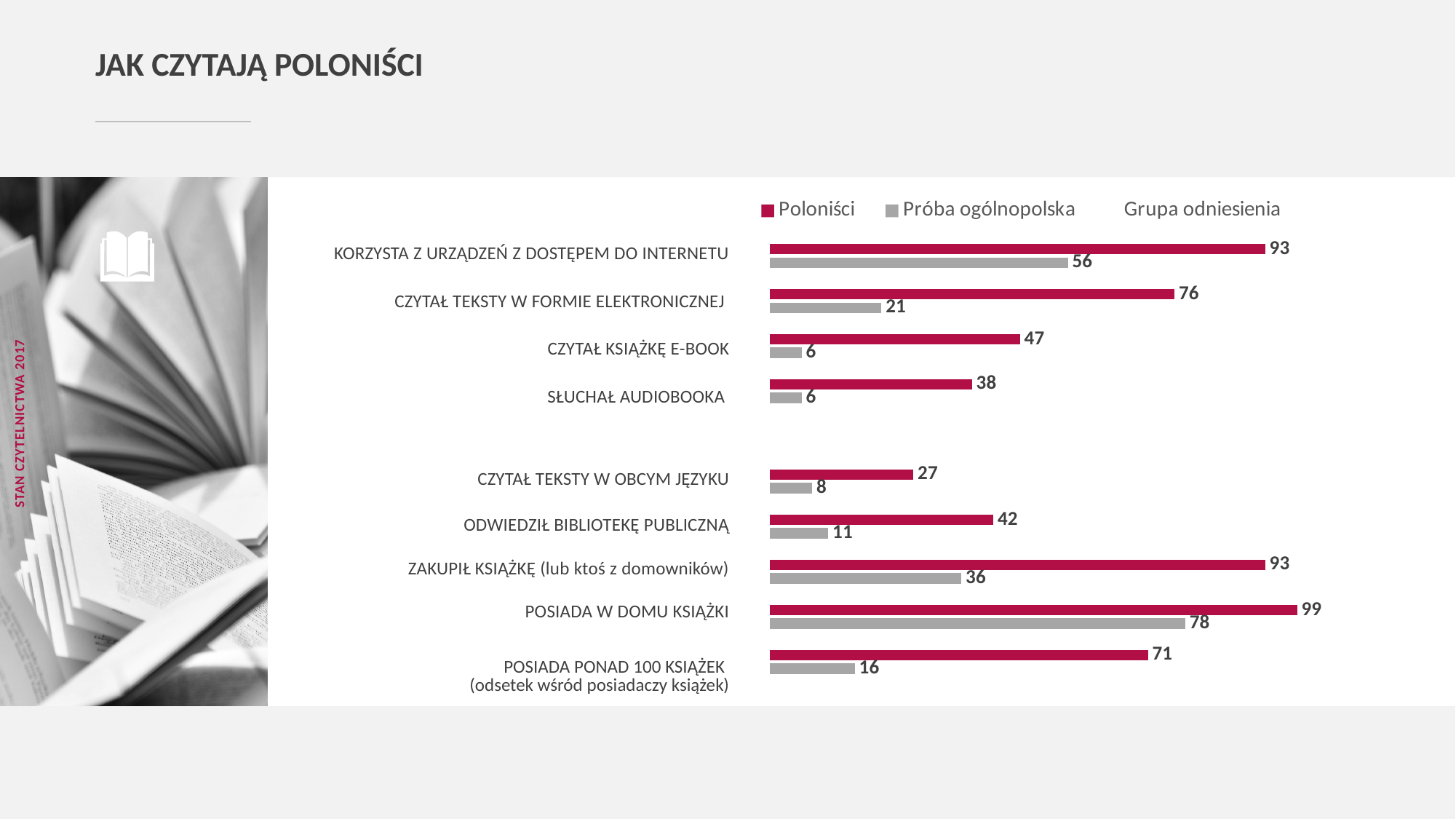
Which category has the highest value for Poloniści? POSIADA W DOMU KSIĄŻKI What is the value for Próba ogólnopolska in the category "KORZYSTA Z URZĄDZEŃ Z DOSTĘPEM DO INTERNETU"? 56 Which colour represents the Poloniści series in the chart? Red What kind of chart is shown on the slide? Bar chart What is the difference between the Poloniści and Próba ogólnopolska values for "ODWIEDZIŁ BIBLIOTEKĘ PUBLICZNĄ"? 31 Which is larger for Poloniści: "SŁUCHAŁ AUDIOBOOKA" or "ODWIEDZIŁ BIBLIOTEKĘ PUBLICZNĄ"? ODWIEDZIŁ BIBLIOTEKĘ PUBLICZNĄ How many categories are shown in the chart? 9 What is the value for Próba ogólnopolska in the category "POSIADA PONAD 100 KSIĄŻEK"? 16 What is the value for Poloniści in the category "CZYTAŁ KSIĄŻKĘ E-BOOK"? 47 What is the difference between the Poloniści and Próba ogólnopolska values for "CZYTAŁ TEKSTY W FORMIE ELEKTRONICZNEJ"? 55 Which category has the highest value for Próba ogólnopolska? POSIADA W DOMU KSIĄŻKI Which category has the lowest value for Poloniści? CZYTAŁ TEKSTY W OBCYM JĘZYKU